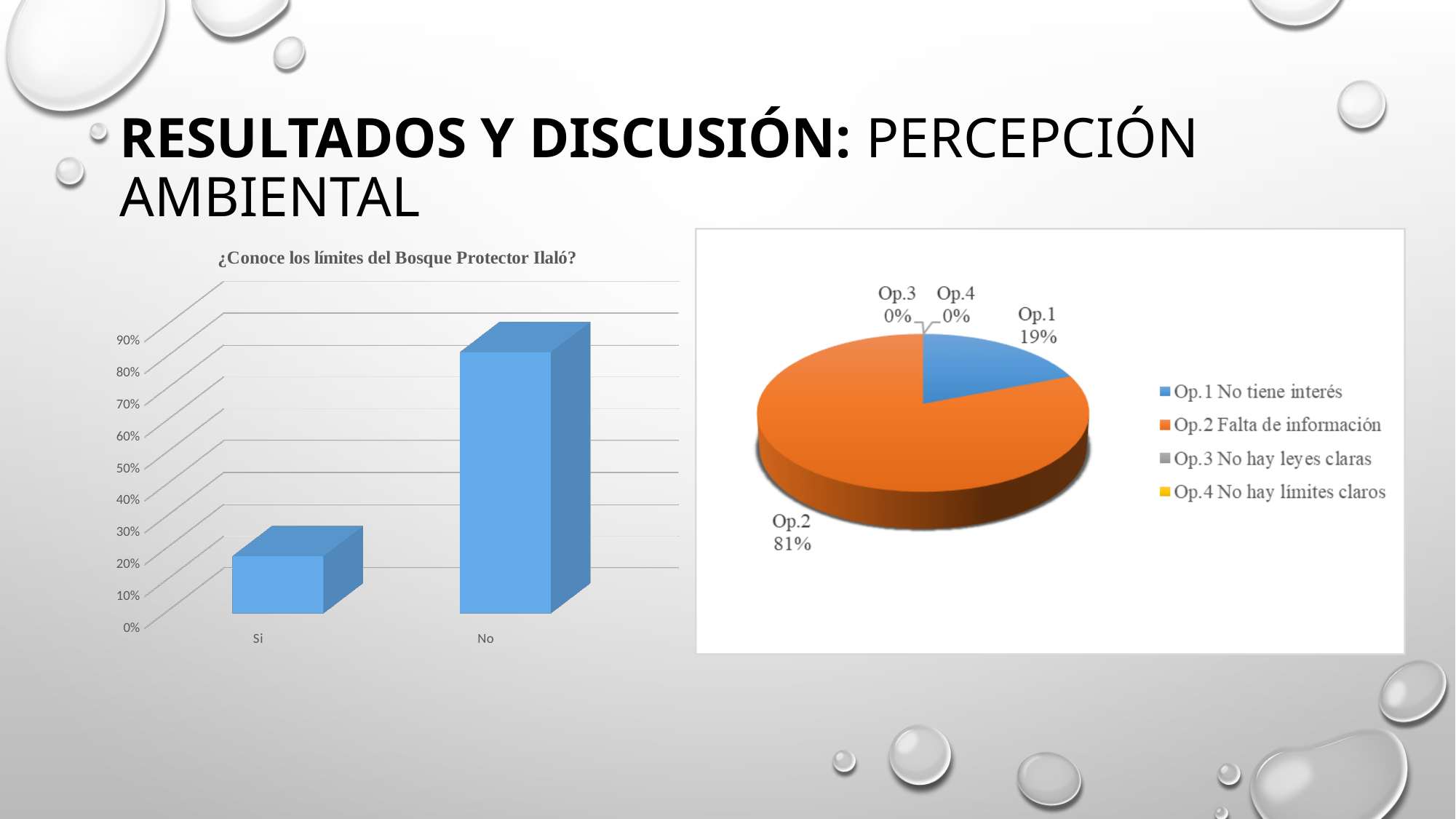
In the pie chart on the right, what percentage is shown for Op.1? 19% In the bar chart titled '¿Conoce los límites del Bosque Protector Ilaló?', what kind of chart is shown? bar chart In the pie chart on the right, what percentage is shown for Op.3? 0% In the bar chart titled '¿Conoce los límites del Bosque Protector Ilaló?', which category has the highest bar? No In the pie chart on the right, what percentage is shown for Op.2? 81% In the bar chart titled '¿Conoce los límites del Bosque Protector Ilaló?', which category has the lowest bar? Si In the bar chart titled '¿Conoce los límites del Bosque Protector Ilaló?', how many categories are shown on the x axis? 2 In the pie chart on the right, which option has the largest share? Op.2 In the pie chart on the right, what does the legend say Op.2 stands for? Falta de información In the bar chart titled '¿Conoce los límites del Bosque Protector Ilaló?', is the value for 'Si' greater or less than 30%? less In the pie chart on the right, what is the difference between the shares of Op.2 and Op.1? 62% In the bar chart titled '¿Conoce los límites del Bosque Protector Ilaló?', is the value for 'No' greater or less than 70%? greater